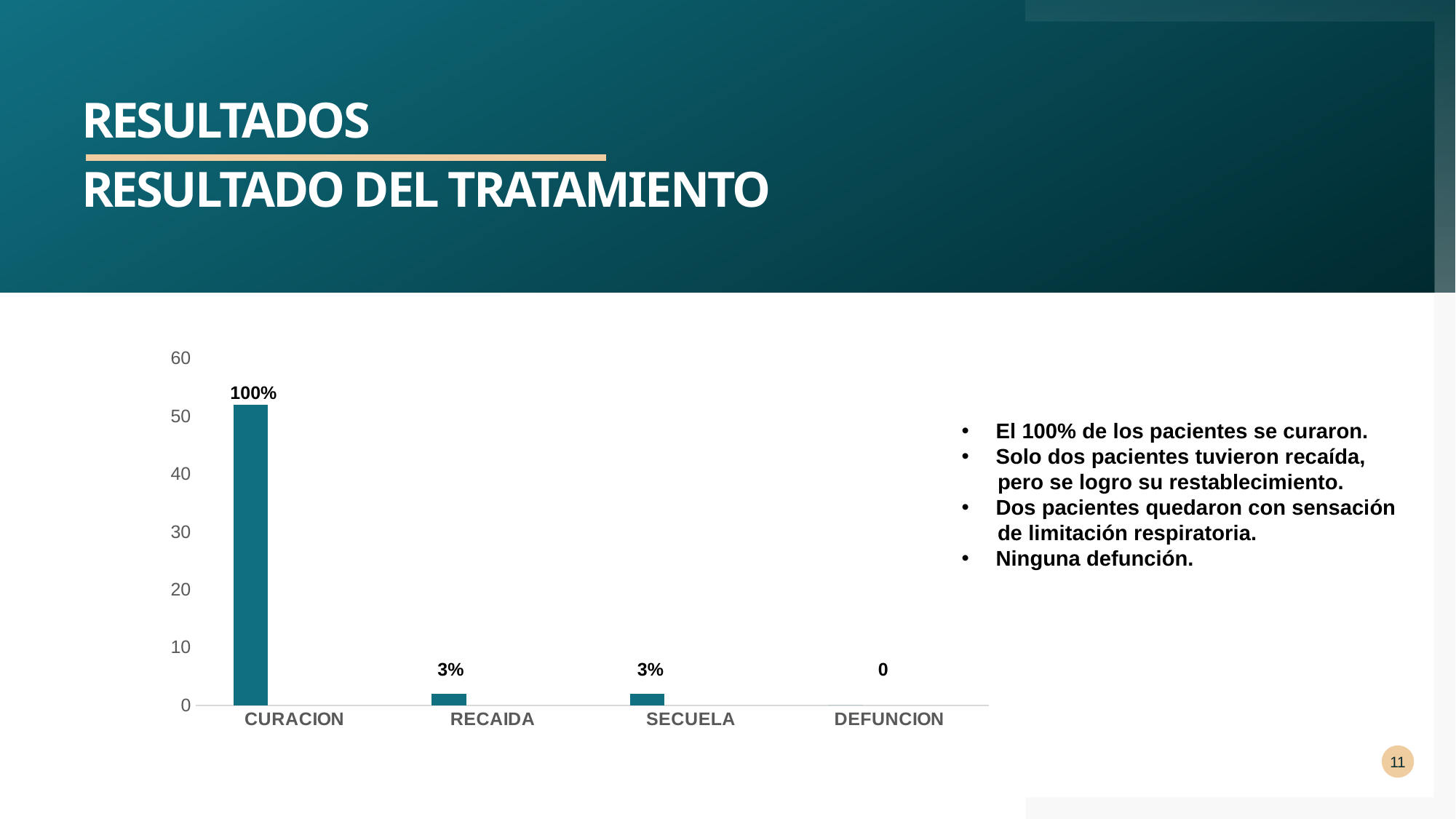
Is the bar for RECAIDA greater or less than 10 on the y axis? less What kind of chart is shown on the slide? bar chart What is the data label shown above the SECUELA bar? 3% Which category has the highest bar in the chart? CURACION Which category has the lowest value in the chart? DEFUNCION Is the bar for CURACION greater or less than 50 on the y axis? greater How many categories are shown on the x axis of the chart? 4 What is the data label shown above the RECAIDA bar? 3% Which is larger, the bar for CURACION or the bar for SECUELA? CURACION What is the data label shown above the CURACION bar? 100% What is the highest value shown on the y axis of the chart? 60 What is the data label shown for DEFUNCION? 0